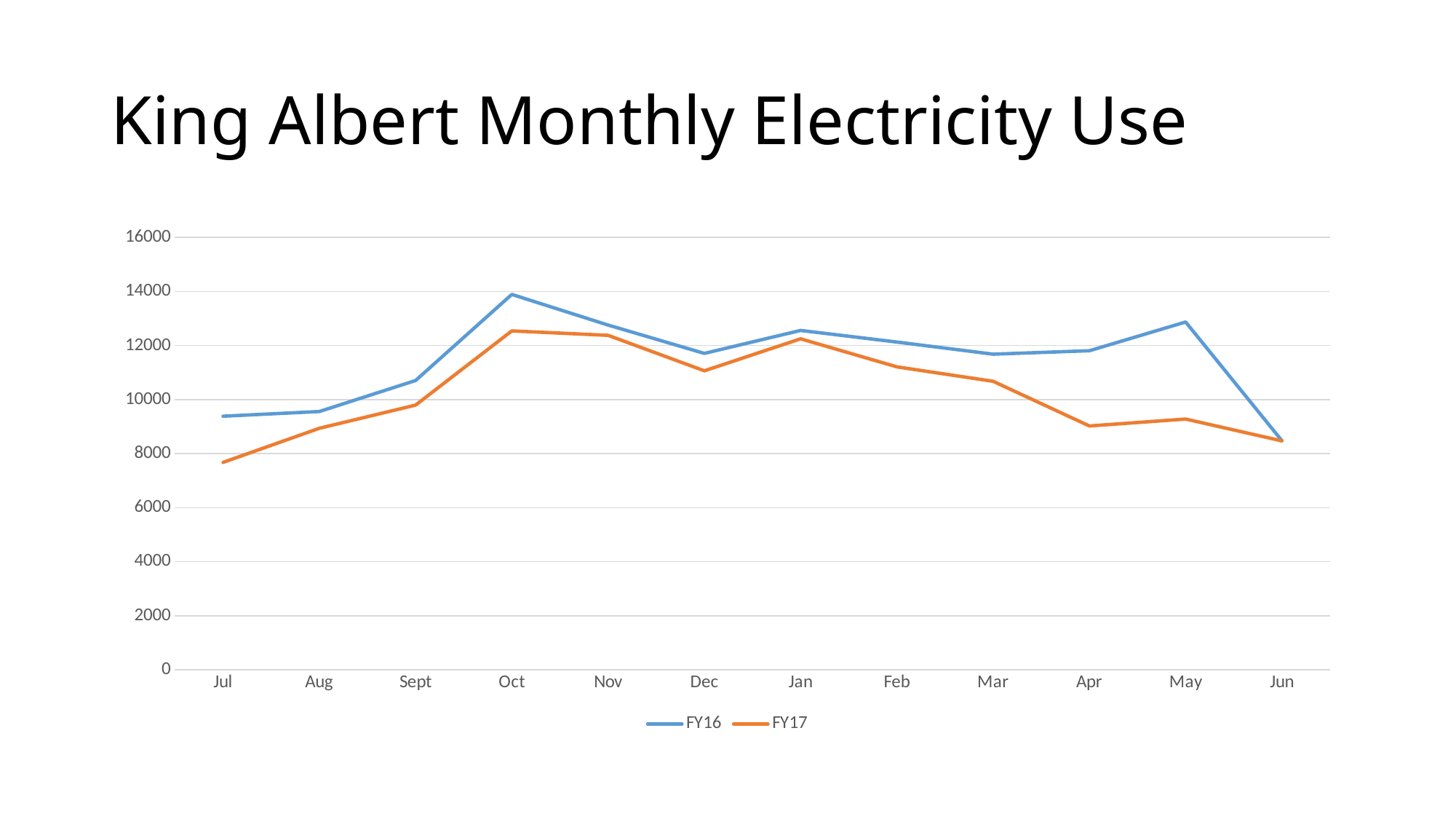
In which month is the FY16 electricity use highest? Oct What colour is the FY17 line? orange Is the FY17 value for Jul greater or less than 8000? less What kind of chart is shown on the slide? line chart Is the FY16 value for Oct greater or less than 12000? greater In which month is the FY16 electricity use lowest? Jun Is the FY17 value for Apr greater or less than 10000? less How many series does the legend list? 2 In which month is the FY17 electricity use lowest? Jul Does the FY17 line rise or fall from Jan to Apr? fall Which series has the larger value in Apr, FY16 or FY17? FY16 How many months are plotted along the x axis? 12